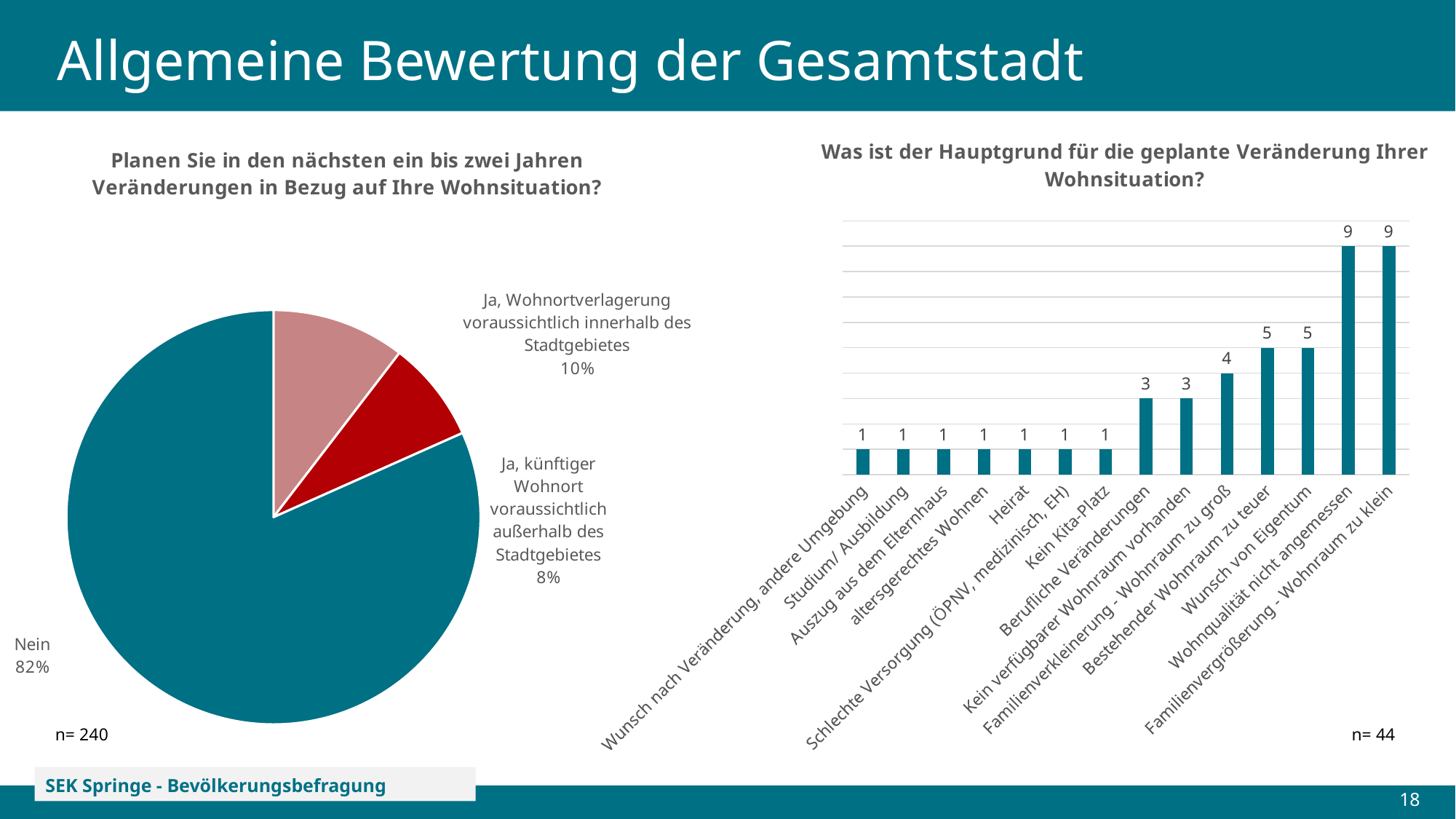
In the bar chart on the right, what is the difference between the value for "Familienvergrößerung - Wohnraum zu klein" and the value for "Bestehender Wohnraum zu teuer"? 4 What kind of chart is the chart on the right ("Was ist der Hauptgrund für die geplante Veränderung Ihrer Wohnsituation?")? bar chart In the pie chart on the left, what share of respondents answered "Nein"? 82% In the pie chart on the left, how many slices does the pie have? 3 In the bar chart on the right, how many categories are shown on the x axis? 14 In the bar chart on the right, what is the value for "Wohnqualität nicht angemessen"? 9 In the bar chart on the right, what is the value for "Familienverkleinerung - Wohnraum zu groß"? 4 In the bar chart on the right, what is the value for "Berufliche Veränderungen"? 3 In the pie chart on the left, what is the sample size (n) shown below the chart? n= 240 In the pie chart on the left, what share of respondents plan a move within the city area ("Ja, Wohnortverlagerung voraussichtlich innerhalb des Stadtgebietes")? 10% In the pie chart on the left, what share of respondents plan a future residence outside the city area ("Ja, künftiger Wohnort voraussichtlich außerhalb des Stadtgebietes")? 8% In the bar chart on the right, do the values rise or fall from left to right along the x axis? rise